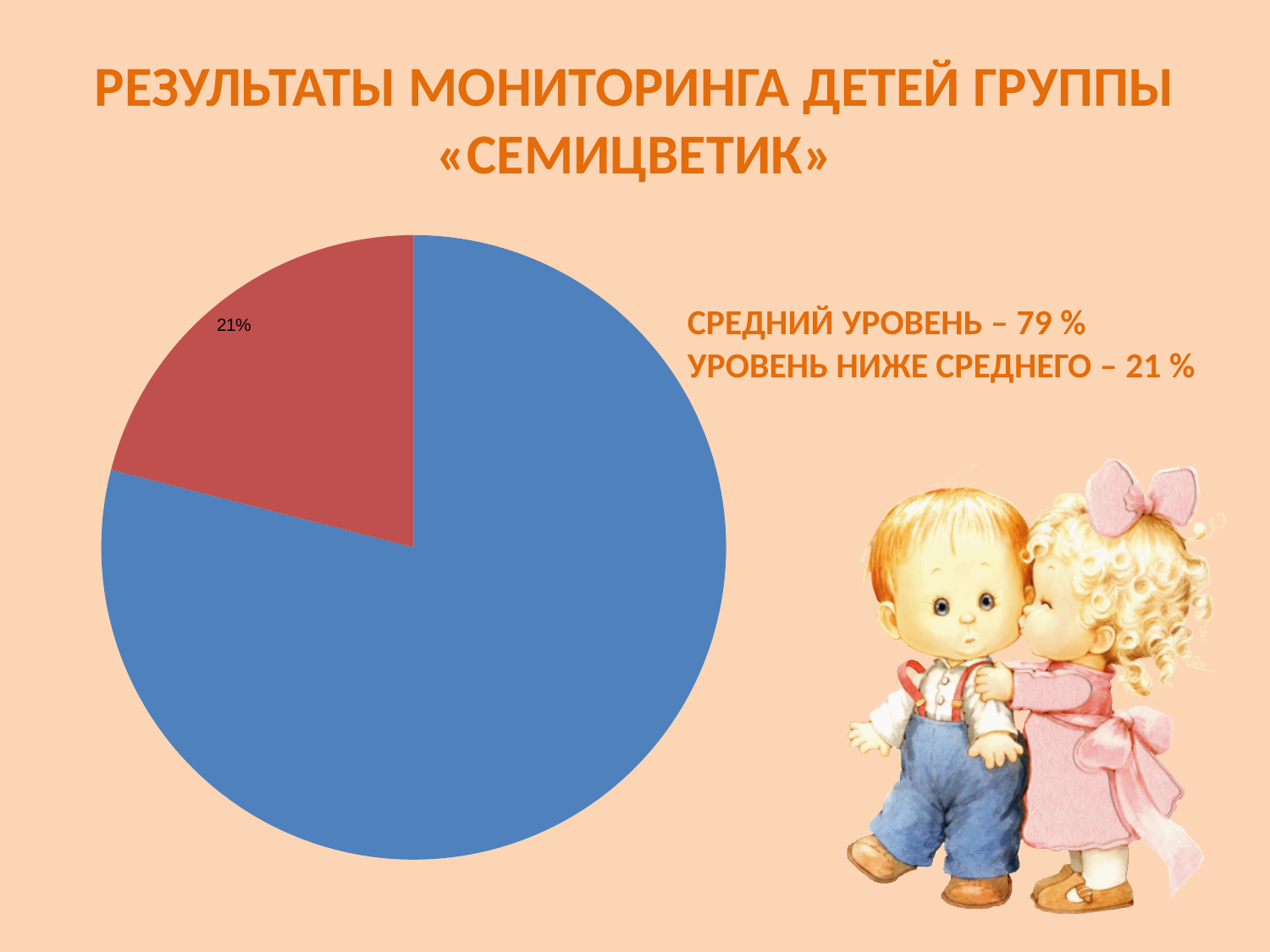
Is the share of the blue slice greater or less than 50%? greater How many slices does the pie chart have? 2 Is the share of the red slice greater or less than 25%? less What percentage is printed on the red slice of the pie chart? 21% What kind of chart is shown on the slide? pie chart What is the difference between the share for «СРЕДНИЙ УРОВЕНЬ» and the share for «УРОВЕНЬ НИЖЕ СРЕДНЕГО» as given on the slide? 58 % What share of the pie does the red slice represent? 21% What is the title of the slide containing the pie chart? РЕЗУЛЬТАТЫ МОНИТОРИНГА ДЕТЕЙ ГРУППЫ «СЕМИЦВЕТИК» According to the text on the slide, what percentage corresponds to «СРЕДНИЙ УРОВЕНЬ»? 79 % Which slice of the pie chart is the smallest? the red slice (21%) Which slice of the pie chart is larger, the blue one or the red one? blue According to the text on the slide, what percentage corresponds to «УРОВЕНЬ НИЖЕ СРЕДНЕГО»? 21 %